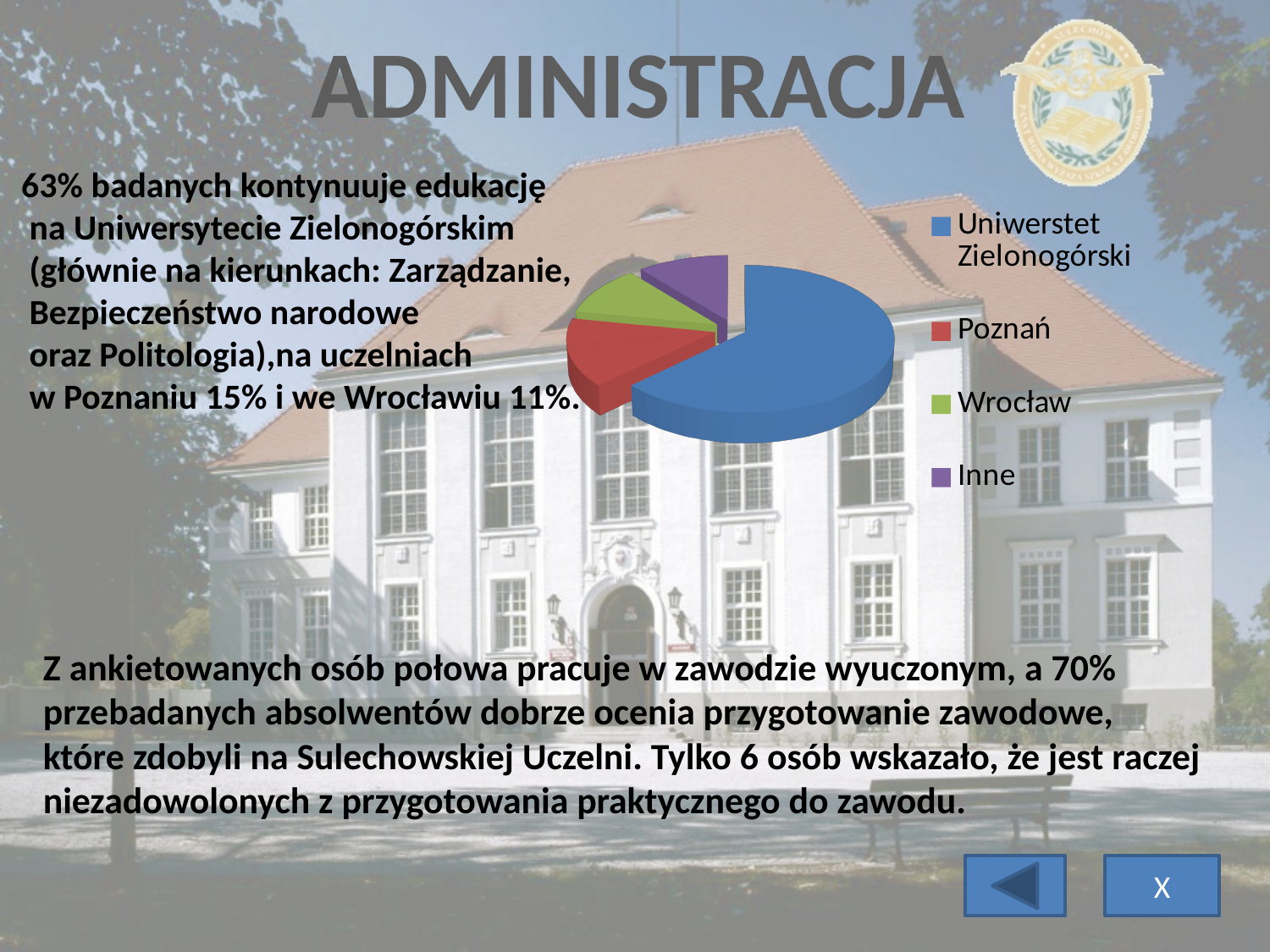
How many slices does the pie chart have? 4 Which category has the largest slice in the pie chart? Uniwerstet Zielonogórski What kind of chart is shown on the slide? pie chart Which category is shown in red in the pie chart? Poznań Does the Uniwerstet Zielonogórski slice take up more or less than half of the pie? more Which slice is larger, Uniwerstet Zielonogórski or Poznań? Uniwerstet Zielonogórski Which slice is larger, Uniwerstet Zielonogórski or Inne? Uniwerstet Zielonogórski What colour is the Uniwerstet Zielonogórski slice in the pie chart? blue How many entries does the legend of the pie chart list? 4 Which slice is larger, Uniwerstet Zielonogórski or Wrocław? Uniwerstet Zielonogórski